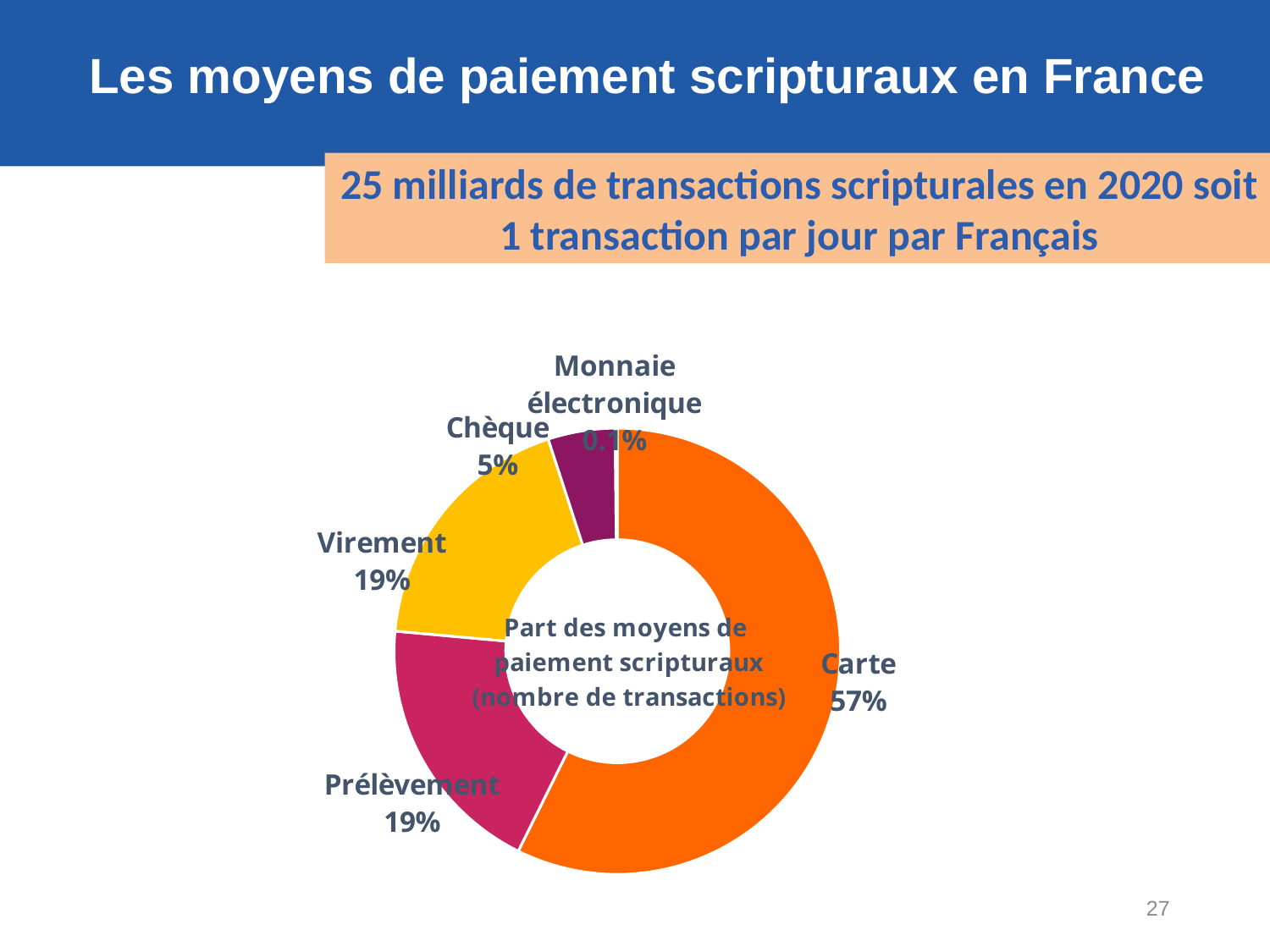
What is the share of Chèque in the chart? 5% What kind of chart is shown on the slide? doughnut chart Which has a larger share, Carte or Virement? Carte Which payment method has the smallest share in the chart? Monnaie électronique What is the difference in share between Virement and Chèque? 14% What is the title shown in the centre of the chart? Part des moyens de paiement scripturaux (nombre de transactions) What is the share of Carte in the chart? 57% Which payment method has the largest share in the chart? Carte What is the difference in share between Carte and Prélèvement? 38% What is the share of Prélèvement in the chart? 19% What is the share of Monnaie électronique in the chart? 0.1% How many payment methods are shown in the chart? 5